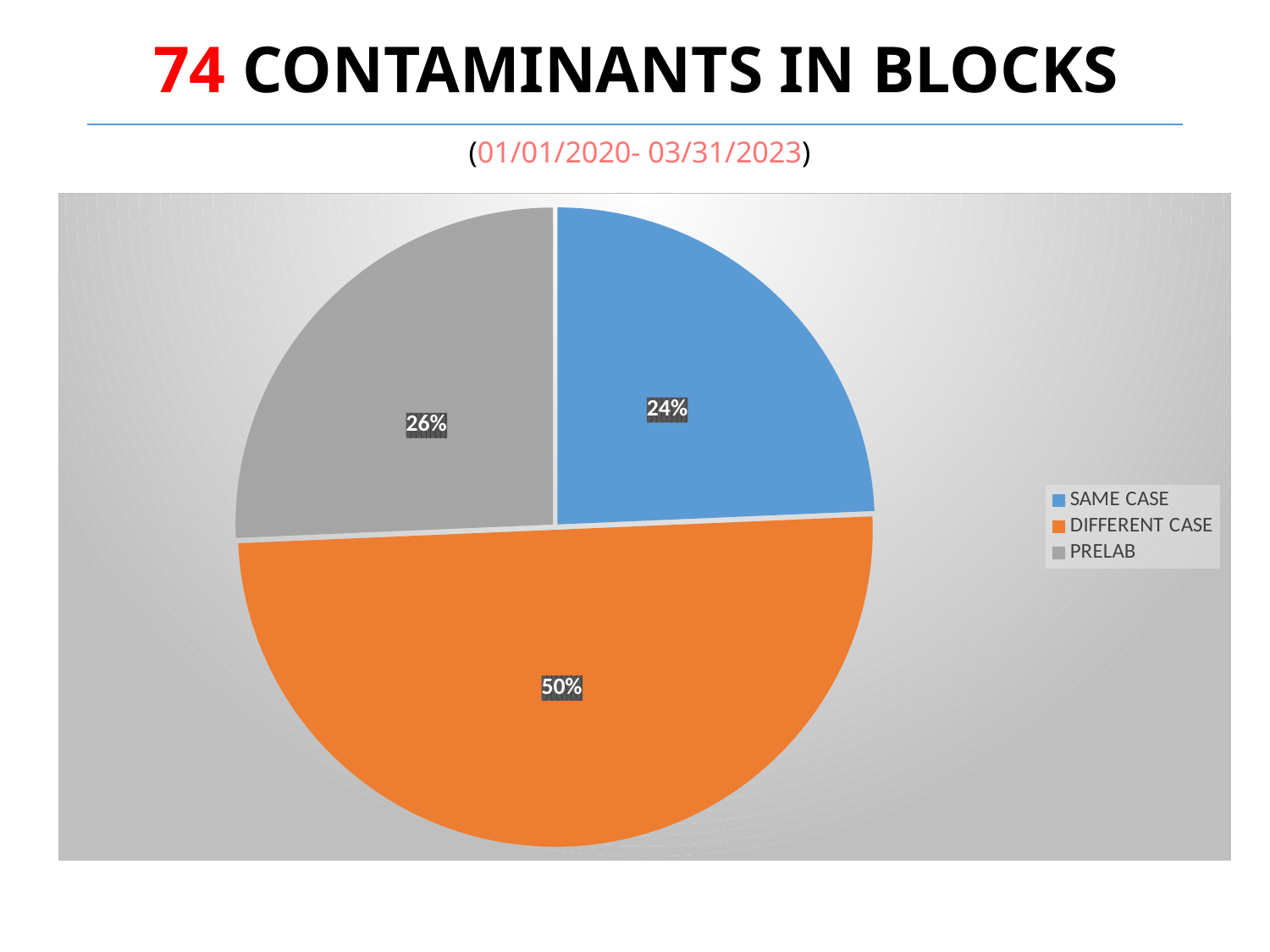
How many slices does the pie chart have? 3 What kind of chart is shown on the slide? Pie chart Which is larger, the DIFFERENT CASE slice or the PRELAB slice? DIFFERENT CASE What share of the pie does PRELAB represent? 26% Which category has the largest slice of the pie? DIFFERENT CASE What is the difference in percentage points between PRELAB and SAME CASE? 2 What date range is shown under the slide title? 01/01/2020- 03/31/2023 What is the difference in percentage points between DIFFERENT CASE and SAME CASE? 26 What share of the pie does SAME CASE represent? 24% Which category has the smallest slice of the pie? SAME CASE What colour is the DIFFERENT CASE slice? Orange What share of the pie does DIFFERENT CASE represent? 50%